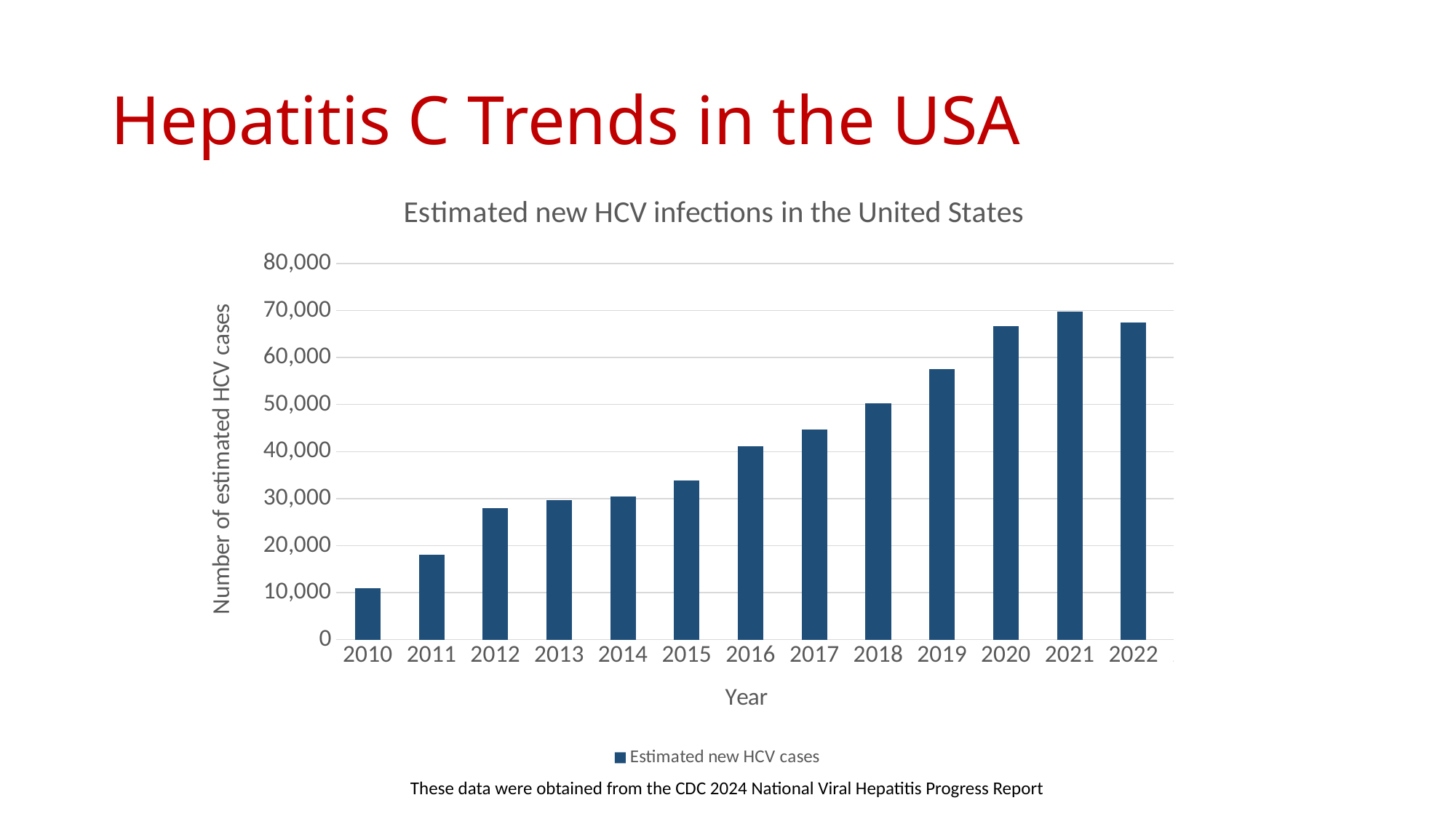
Is the value for 2017 greater or less than 50,000? less What is the title of the chart? Estimated new HCV infections in the United States How many years are shown on the x axis of the chart? 13 Is the value for 2010 greater or less than 20,000? less Do the estimated new HCV cases generally rise or fall from 2010 to 2022? rise Is the value for 2019 greater or less than 50,000? greater How many series does the legend list? 1 Which year has more estimated new HCV cases, 2015 or 2016? 2016 What kind of chart is shown on the slide? bar chart Which year has the lowest number of estimated new HCV cases? 2010 Which year has the highest number of estimated new HCV cases? 2021